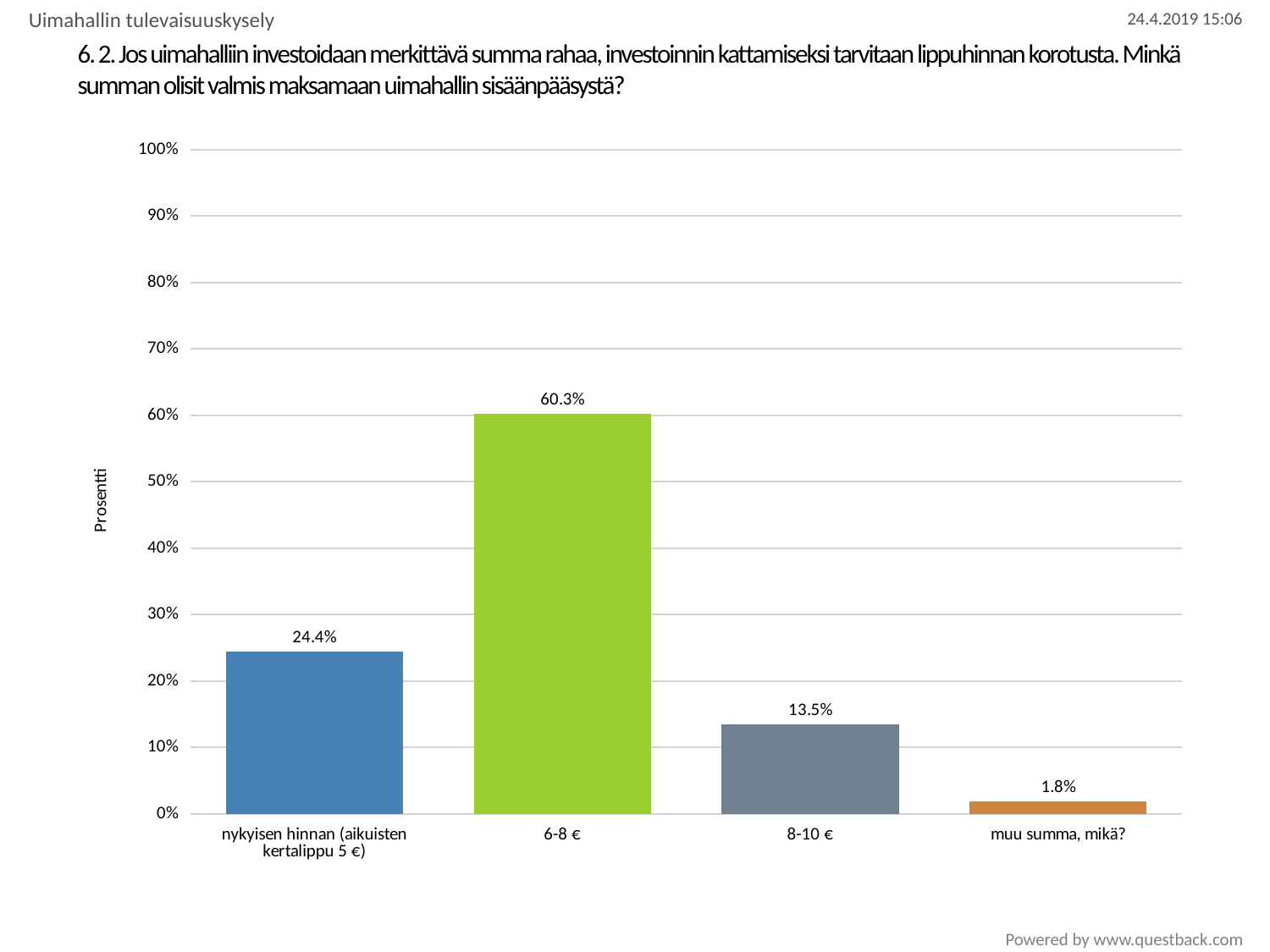
What is the label of the y axis? Prosentti What percentage of respondents chose "6-8 €"? 60.3% What is the difference between the values for "6-8 €" and "8-10 €"? 46.8% Which is larger, the value for "nykyisen hinnan (aikuisten kertalippu 5 €)" or the value for "8-10 €"? nykyisen hinnan (aikuisten kertalippu 5 €) What is the value for "8-10 €"? 13.5% What is the value for "nykyisen hinnan (aikuisten kertalippu 5 €)"? 24.4% Which category has the highest value? 6-8 € How many categories are shown on the x axis? 4 What is the value for "muu summa, mikä?"? 1.8% Is the value for "6-8 €" greater or less than 50%? greater What kind of chart is shown on the slide? bar chart Which category has the lowest value? muu summa, mikä?